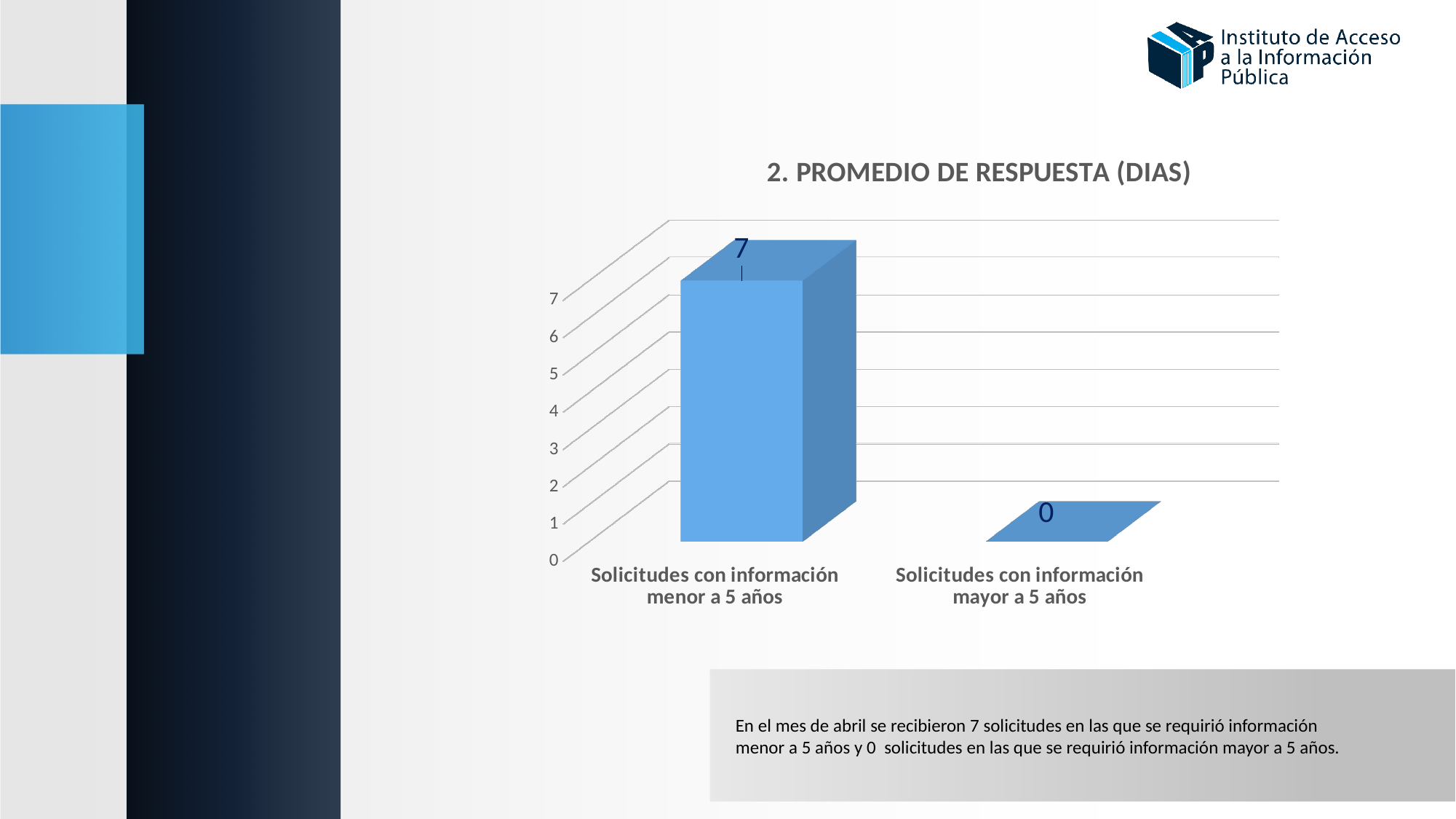
Which category has the lowest value? Solicitudes con información mayor a 5 años Which category has the highest value? Solicitudes con información menor a 5 años What is the highest value shown on the vertical axis of the chart? 7 What is the difference between the values for "Solicitudes con información menor a 5 años" and "Solicitudes con información mayor a 5 años"? 7 What is the value for "Solicitudes con información mayor a 5 años"? 0 Which is larger: the value for "Solicitudes con información menor a 5 años" or for "Solicitudes con información mayor a 5 años"? Solicitudes con información menor a 5 años Is the value for "Solicitudes con información menor a 5 años" greater or less than 5? greater What kind of chart is shown on the slide? bar chart What is the value for "Solicitudes con información menor a 5 años"? 7 What is the title of the chart? 2. PROMEDIO DE RESPUESTA (DIAS) How many categories are shown on the chart? 2